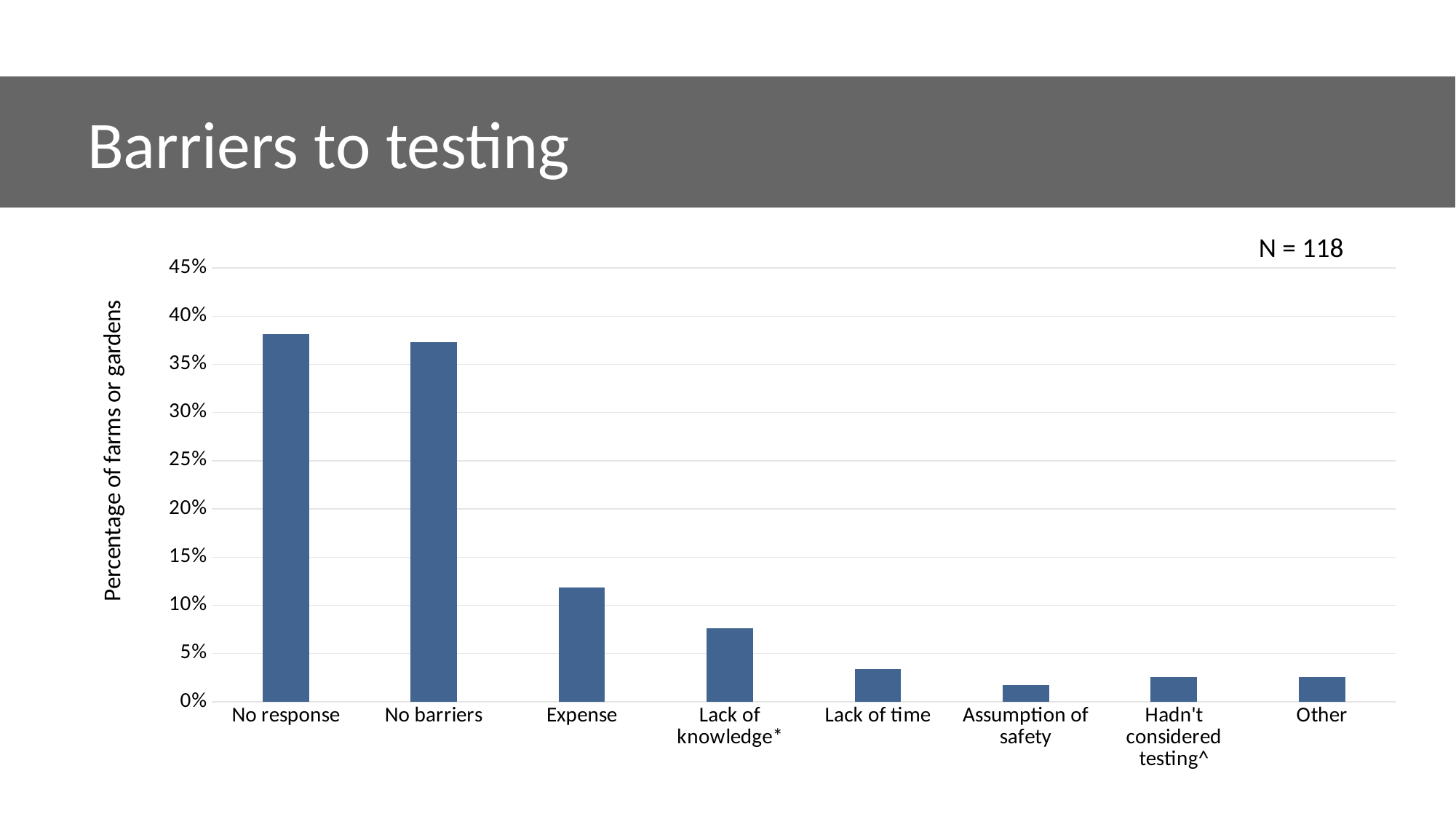
Is the value for No response greater or less than 35%? greater What kind of chart is shown on the slide? bar chart How many categories are shown on the x axis of the chart? 8 What sample size (N) is noted on the chart? N = 118 Is the value for No barriers greater or less than 40%? less Is the value for Lack of knowledge* greater or less than 10%? less Which has the larger value, Expense or Lack of knowledge*? Expense Do the values generally rise or fall moving from left to right along the x axis? fall Which category has the lowest value in the chart? Assumption of safety What is the title of the chart's vertical axis? Percentage of farms or gardens